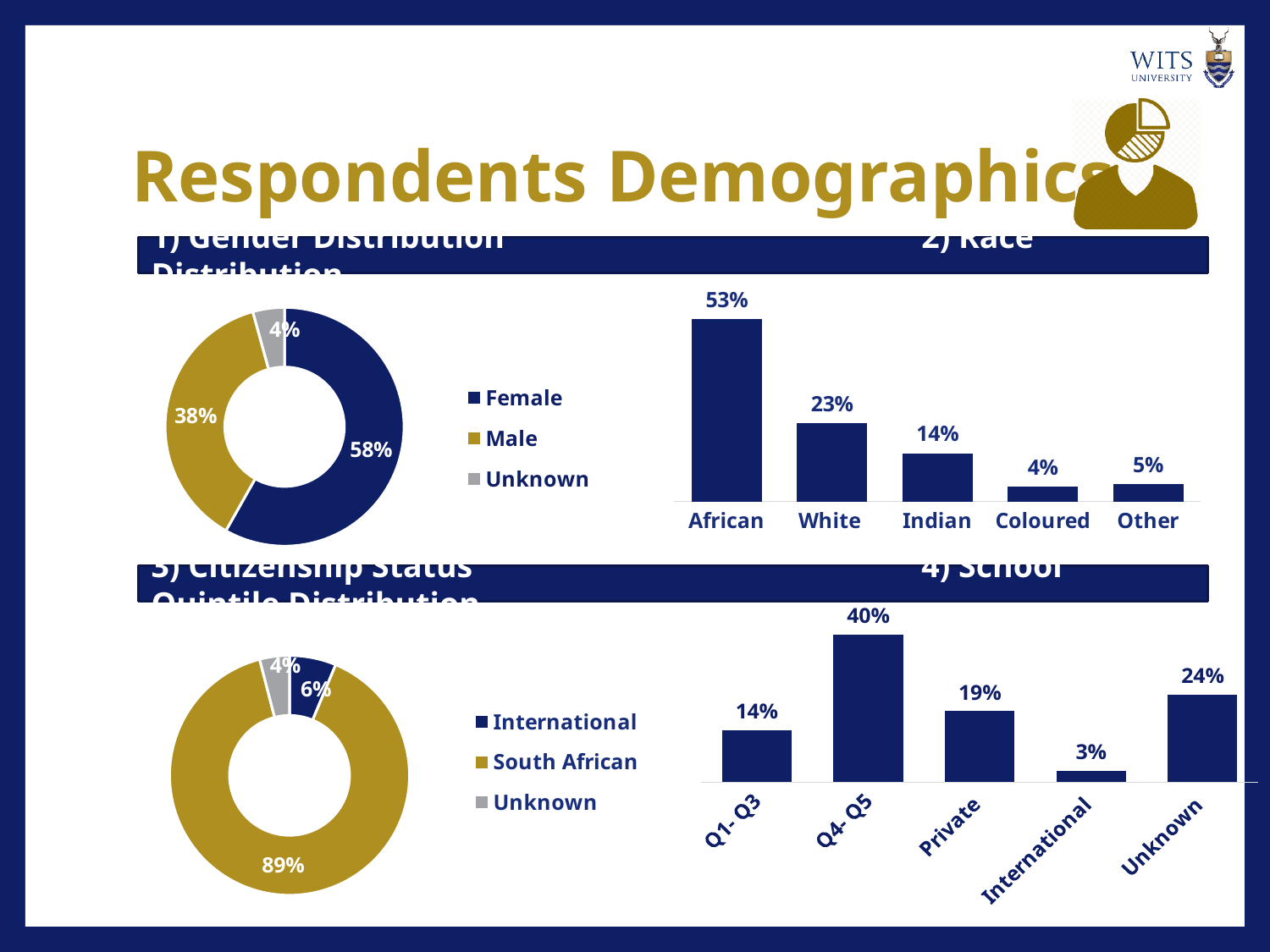
In the Race Distribution chart, which race category has the lowest value? Coloured In the School Quintile Distribution chart, which category has the highest value? Q4- Q5 In the Race Distribution chart, what is the difference between the White and Indian percentages? 9% In the Gender Distribution chart, what percentage of respondents are Male? 38% What kind of chart is the Race Distribution chart? Bar chart In the Gender Distribution chart, what percentage of respondents are Female? 58% In the Gender Distribution chart, how many categories does the legend list? 3 In the Citizenship Status chart, which is larger, International or Unknown? International In the School Quintile Distribution chart, what is the value for Private? 19% In the Citizenship Status chart, what percentage of respondents are South African? 89% In the Race Distribution chart, what percentage of respondents are African? 53% In the Race Distribution chart, how many race categories are shown? 5